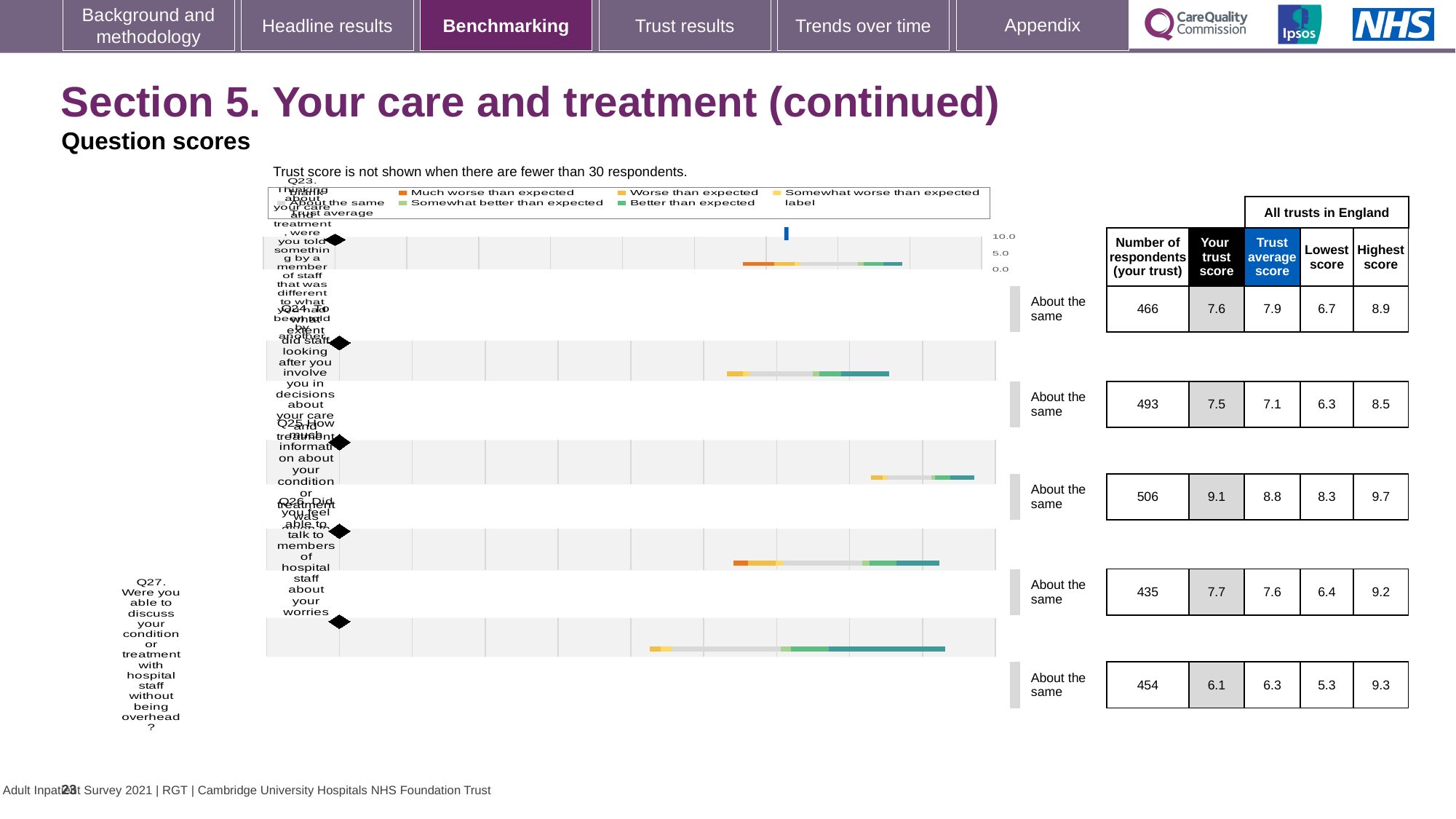
What is the 'Your trust score' for Q23 in the table beside the chart? 7.6 How many respondents are listed for Q24? 493 How many questions (Q23 to Q27) are plotted in the chart? 5 For Q24, which is larger: the trust score or the trust average score? trust score Which question has the highest 'Your trust score' in the table? Q25 What is the difference between the highest and lowest scores for Q27? 4.0 What is the lowest score across all trusts in England for Q27? 5.3 What kind of chart is used to show the question scores on this slide? bar chart What benchmark label is shown next to the chart for Q23? About the same What is the difference between the trust score and the trust average score for Q25? 0.3 Which question has the lowest 'Your trust score' in the table? Q27 What is the highest score across all trusts in England for Q26? 9.2